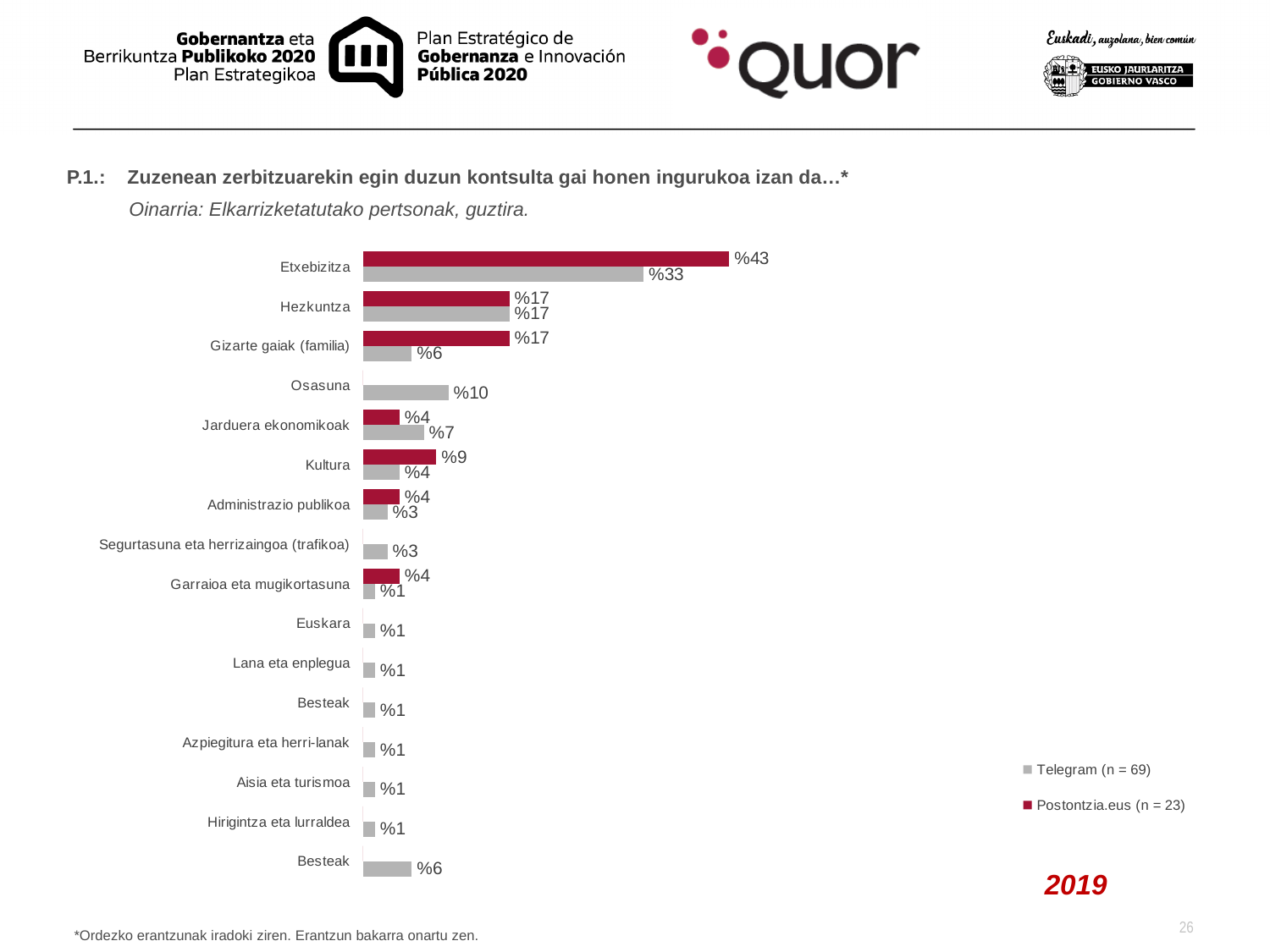
For Jarduera ekonomikoak, which series has the larger value, Telegram or Postontzia.eus? Telegram For Kultura, which series has the larger value, Telegram or Postontzia.eus? Postontzia.eus What is the difference between the Postontzia.eus and Telegram values for Etxebizitza? %10 What is the Telegram value for Osasuna? %10 What is the difference between the Postontzia.eus and Telegram values for Gizarte gaiak (familia)? %11 How many series does the legend list? 2 What is the Telegram value for Etxebizitza? %33 What kind of chart is shown on the slide? Bar chart Which category has the highest Telegram value? Etxebizitza What is the Postontzia.eus value for Etxebizitza? %43 What is the sample size (n) shown in the legend for Telegram? 69 What is the Postontzia.eus value for Kultura? %9